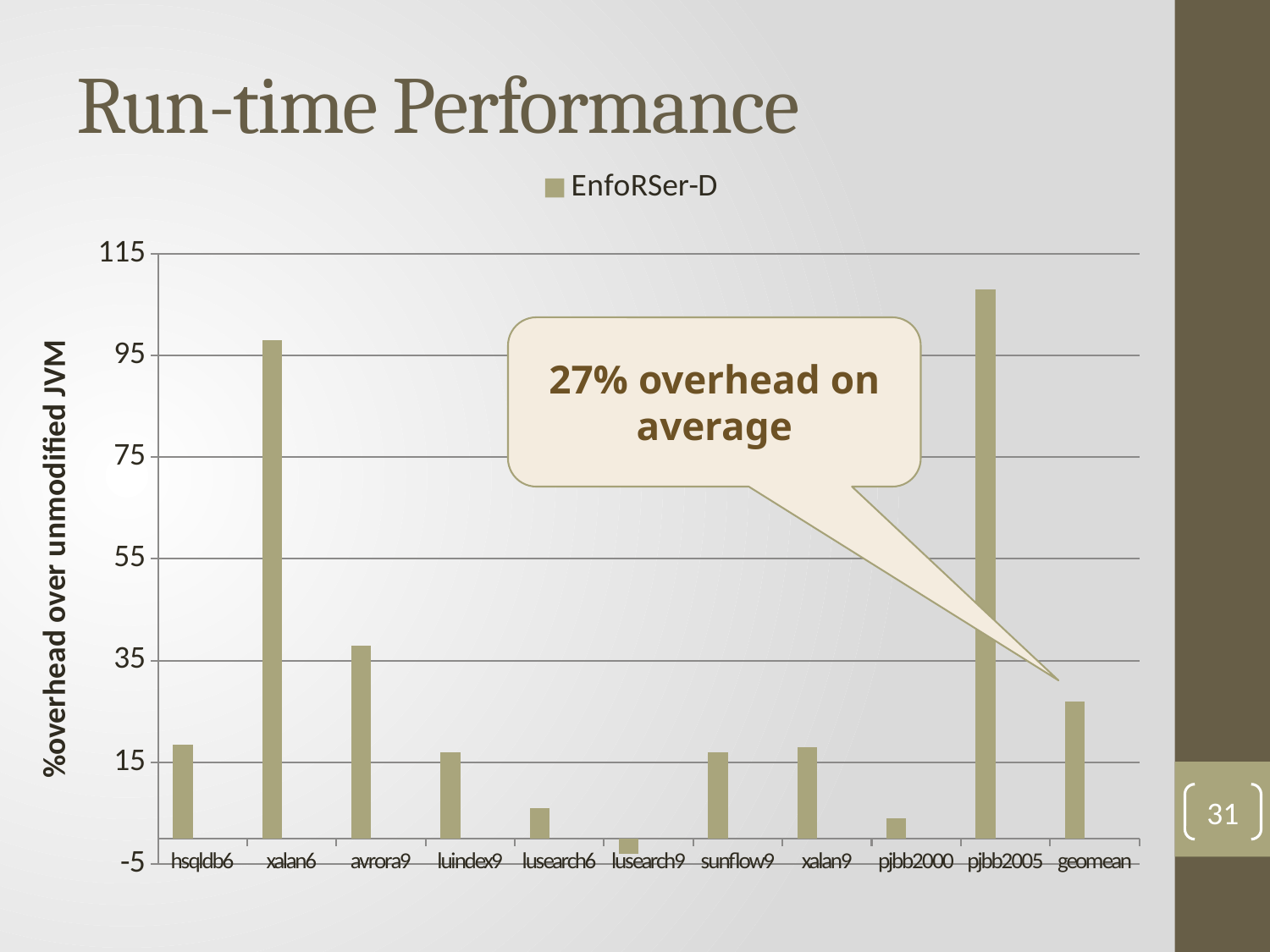
Which has a larger overhead, pjbb2005 or xalan6? pjbb2005 What kind of chart is shown on the slide? bar chart Which has a larger overhead, xalan6 or avrora9? xalan6 Which category has the lowest overhead? lusearch9 What is the label of the y axis? %overhead over unmodified JVM Is the value for avrora9 greater or less than 55? less How many series does the legend list? 1 How many benchmark categories are plotted along the x axis? 11 Is the value for pjbb2005 greater or less than 95? greater Which category has the highest overhead? pjbb2005 What series name is shown in the legend? EnfoRSer-D Is the value for lusearch6 greater or less than 15? less